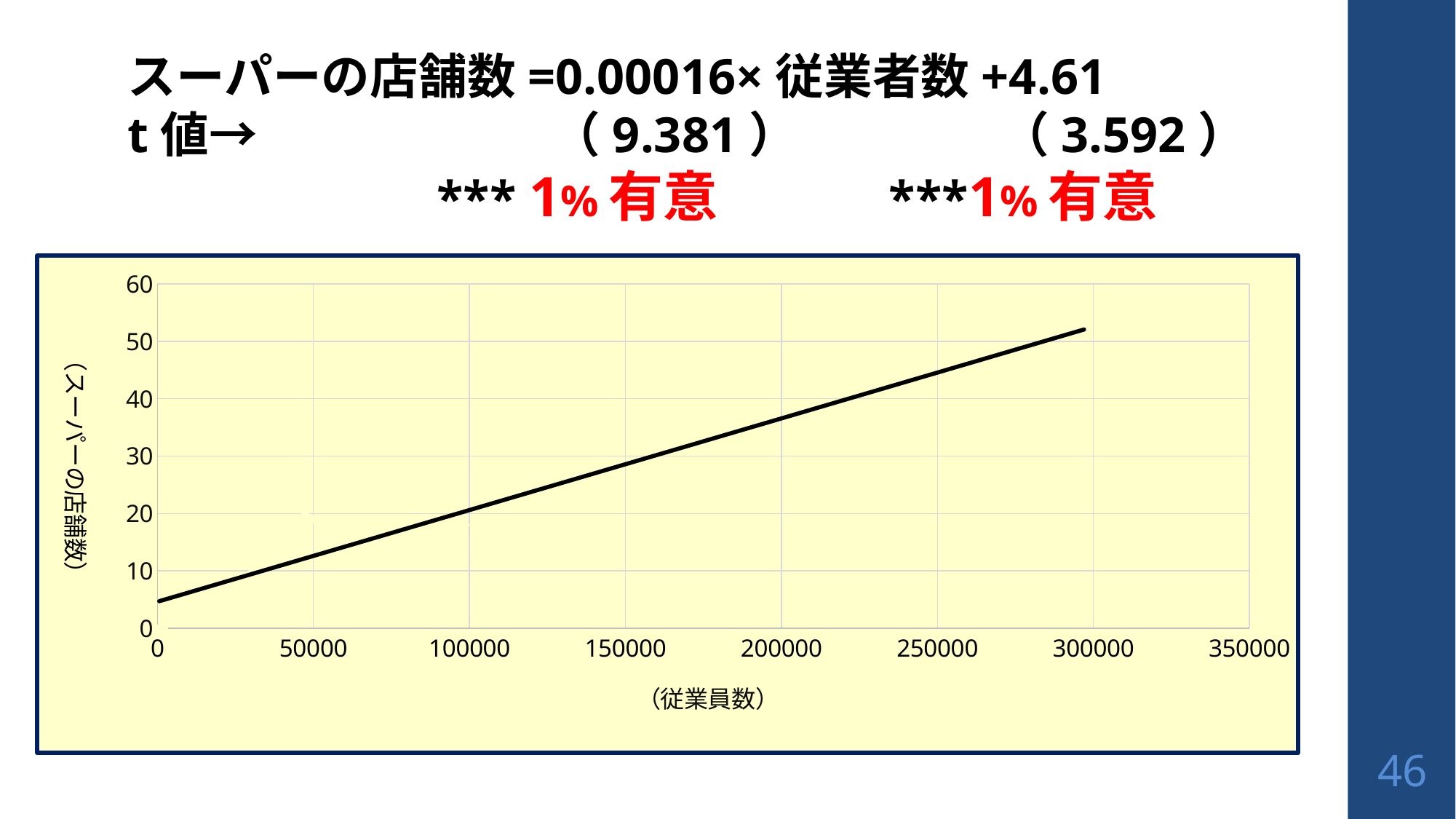
Is the value of the line at 200000 employees greater or less than 30? greater Is the highest point of the line greater or less than 60? less What is the label of the horizontal axis of the chart? （従業員数） Is the value of the line at 250000 employees greater or less than 40? greater What is the largest tick value shown on the vertical axis? 60 What is the label of the vertical axis of the chart? （スーパーの店舗数） Do the values on the chart rise or fall as the number of employees (従業員数) increases along the x axis? rise What is the largest tick value shown on the horizontal axis? 350000 What kind of chart is shown on the slide? line chart